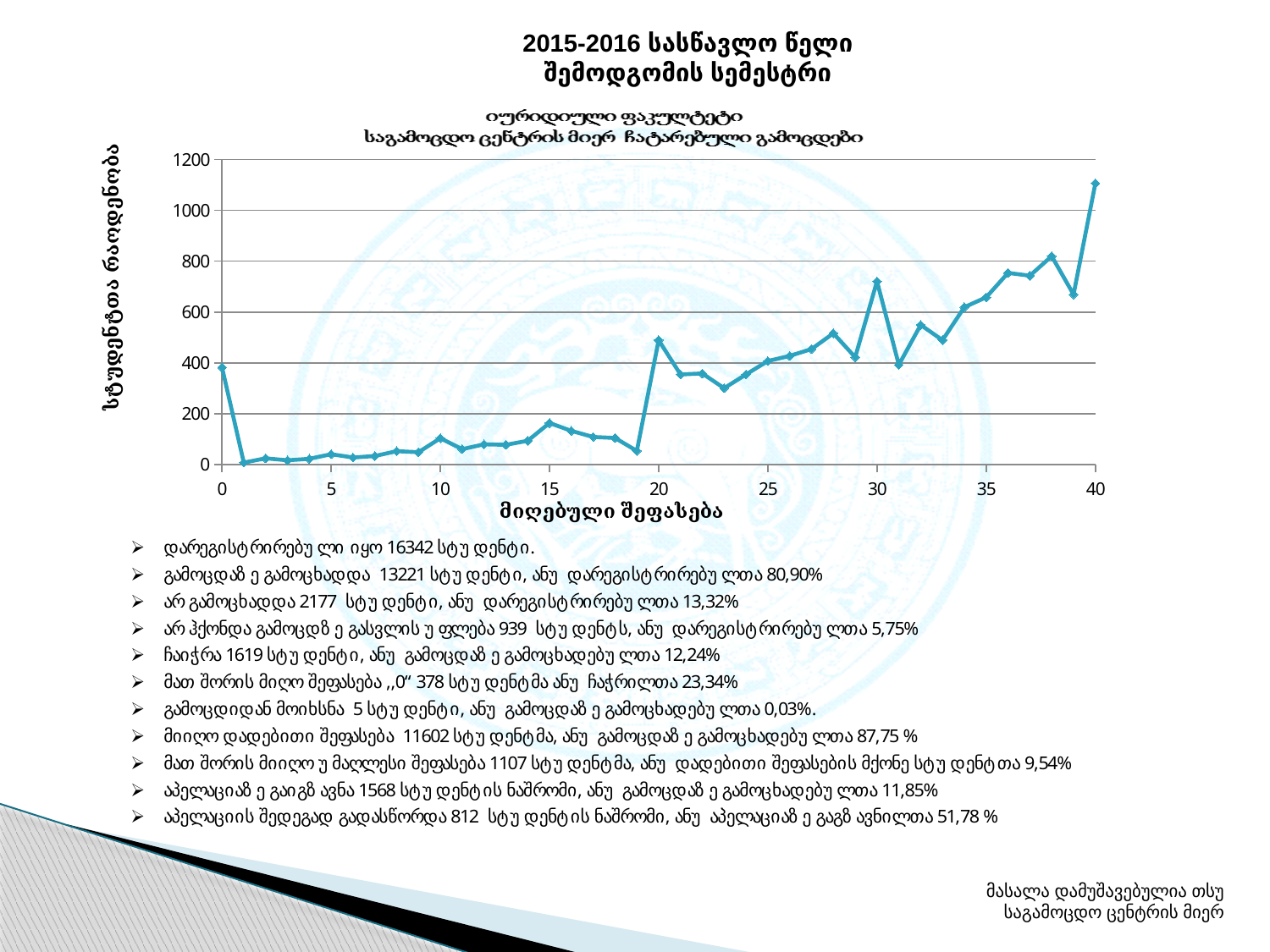
Is the value at x = 30 greater or less than 600? greater Is the value at x = 40 greater or less than 1000? greater At which x-axis value (score) does the line reach its highest point? 40 What kind of chart is shown on the slide? line chart Which is larger, the value at x = 30 or the value at x = 31? x = 30 Is the value at x = 15 greater or less than 200? less What is the label of the y-axis? სტუდენტთა რაოდენობა Overall, do the values rise or fall as the x-axis value increases from 20 to 40? rise What is the highest tick value shown on the y-axis? 1200 Which is larger, the value at x = 19 or the value at x = 20? x = 20